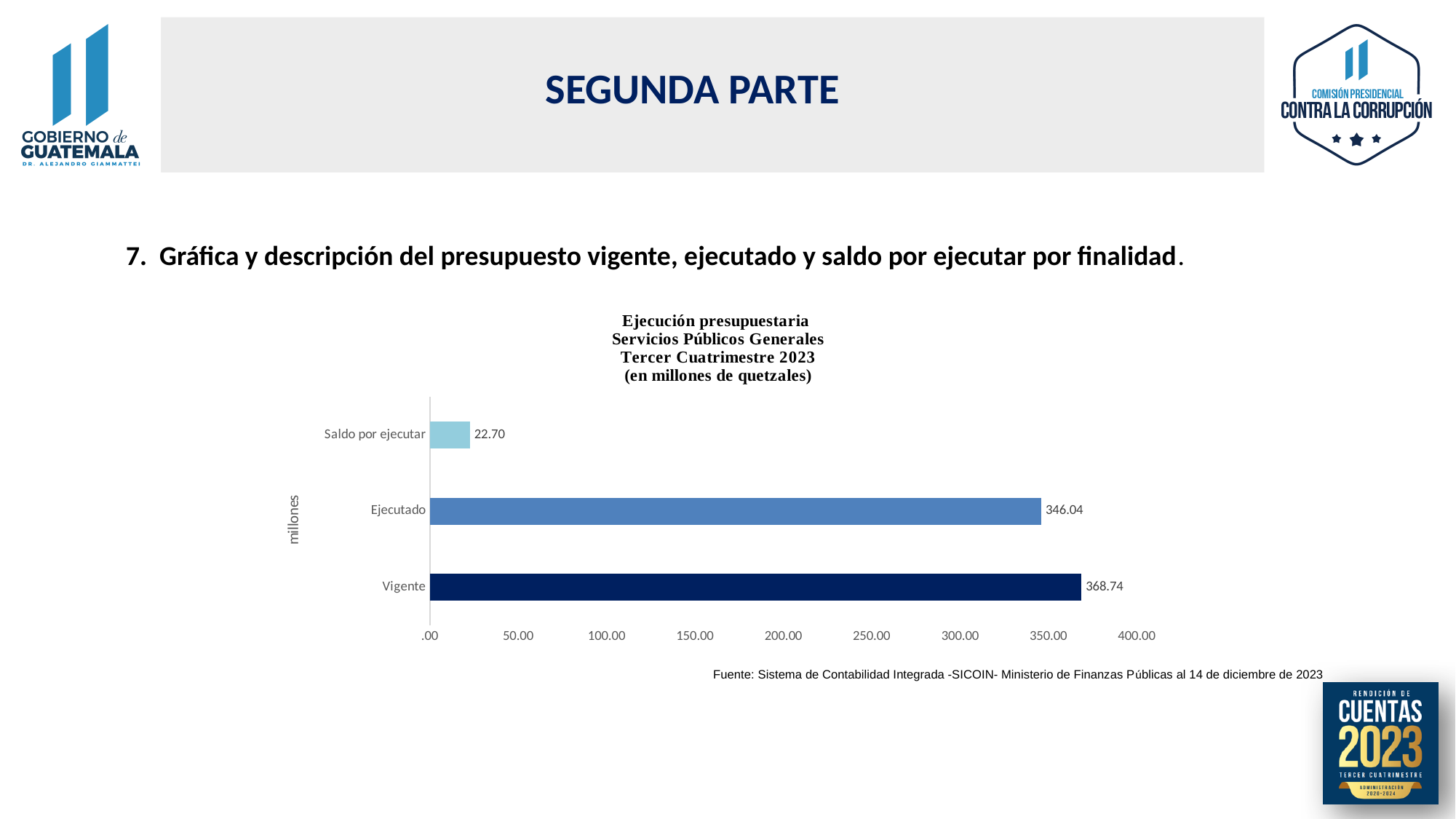
What is the value for Vigente? 368.74 Which category has the highest value? Vigente What kind of chart is shown on the slide? Bar chart Which is larger, Ejecutado or Saldo por ejecutar? Ejecutado What is the value for Ejecutado? 346.04 What is the difference between Vigente and Ejecutado? 22.70 What is the difference between Ejecutado and Saldo por ejecutar? 323.34 Which category has the lowest value? Saldo por ejecutar How many categories are shown in the chart? 3 What is the value for Saldo por ejecutar? 22.70 Is the value for Ejecutado greater or less than 300.00? greater What is the label on the vertical axis of the chart? millones